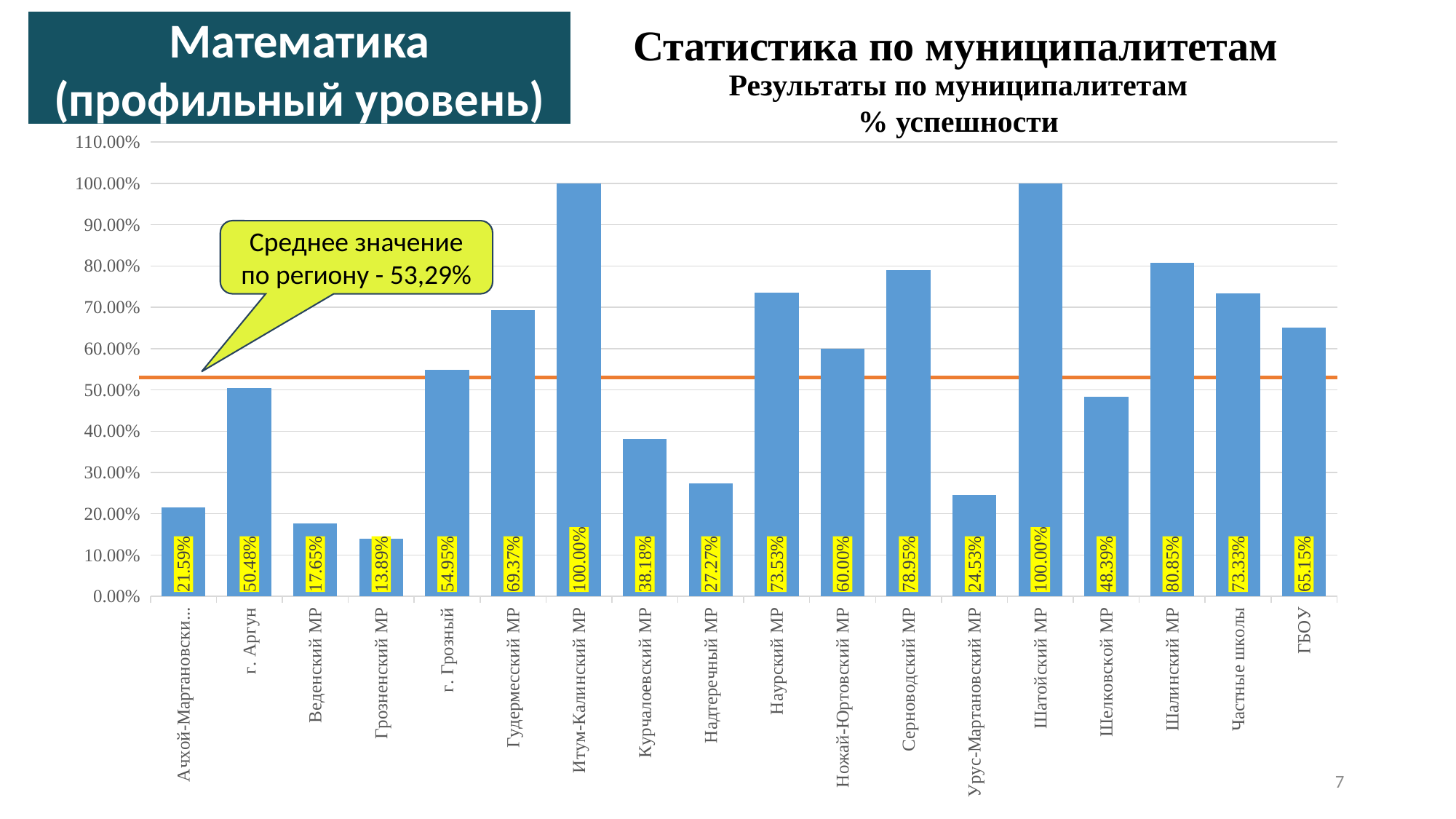
Which category has the lowest value? Грозненский МР What is the value for Частные школы? 73.33% What regional average value is stated in the callout on the chart? 53,29% Is the value for Серноводский МР greater or less than 70.00%? greater Which is larger, the value for г. Аргун or the value for г. Грозный? г. Грозный What is the value for Шелковской МР? 48.39% What is the value for Гудермесский МР? 69.37% How many categories are shown on the x axis? 18 Which two categories share the highest value of 100.00%? Итум-Калинский МР and Шатойский МР What is the difference between the values for Шалинский МР and Наурский МР? 7.32% What kind of chart is shown on the slide? bar chart What is the value for Урус-Мартановский МР? 24.53%